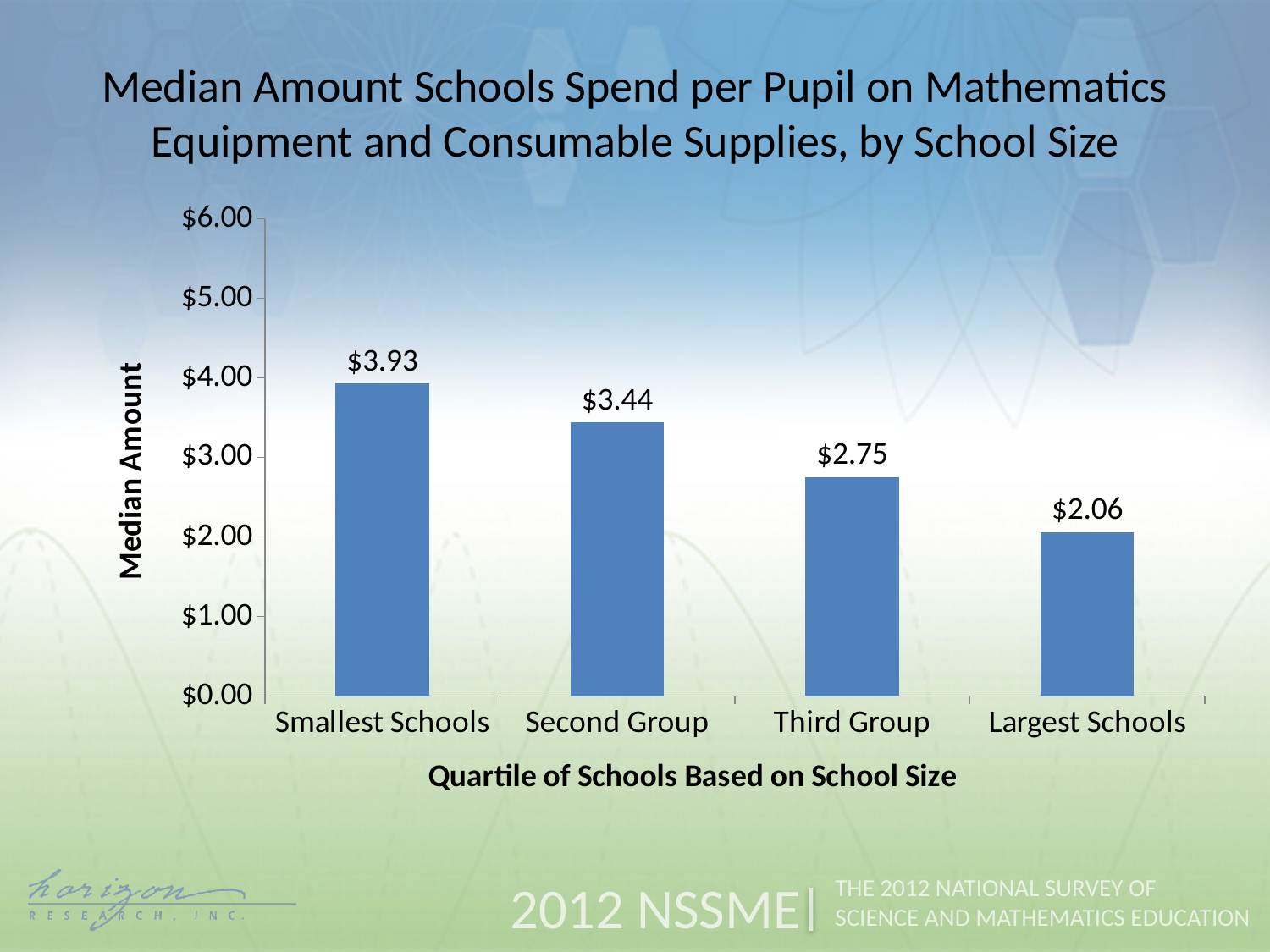
How many quartile categories are shown on the x axis? 4 Which quartile of schools has the highest median amount spent per pupil? Smallest Schools What is the median amount spent per pupil for Smallest Schools? $3.93 Which quartile of schools has the lowest median amount spent per pupil? Largest Schools Do the median amounts rise or fall moving from Smallest Schools to Largest Schools? Fall What is the median amount spent per pupil for Largest Schools? $2.06 What is the median amount spent per pupil for the Third Group? $2.75 What is the median amount spent per pupil for the Second Group? $3.44 What kind of chart is shown on the slide? Bar chart What is the difference between the median amounts for Smallest Schools and Largest Schools? $1.87 Which has a larger median amount, the Second Group or the Third Group? Second Group Is the value for the Third Group greater or less than $3.00? less